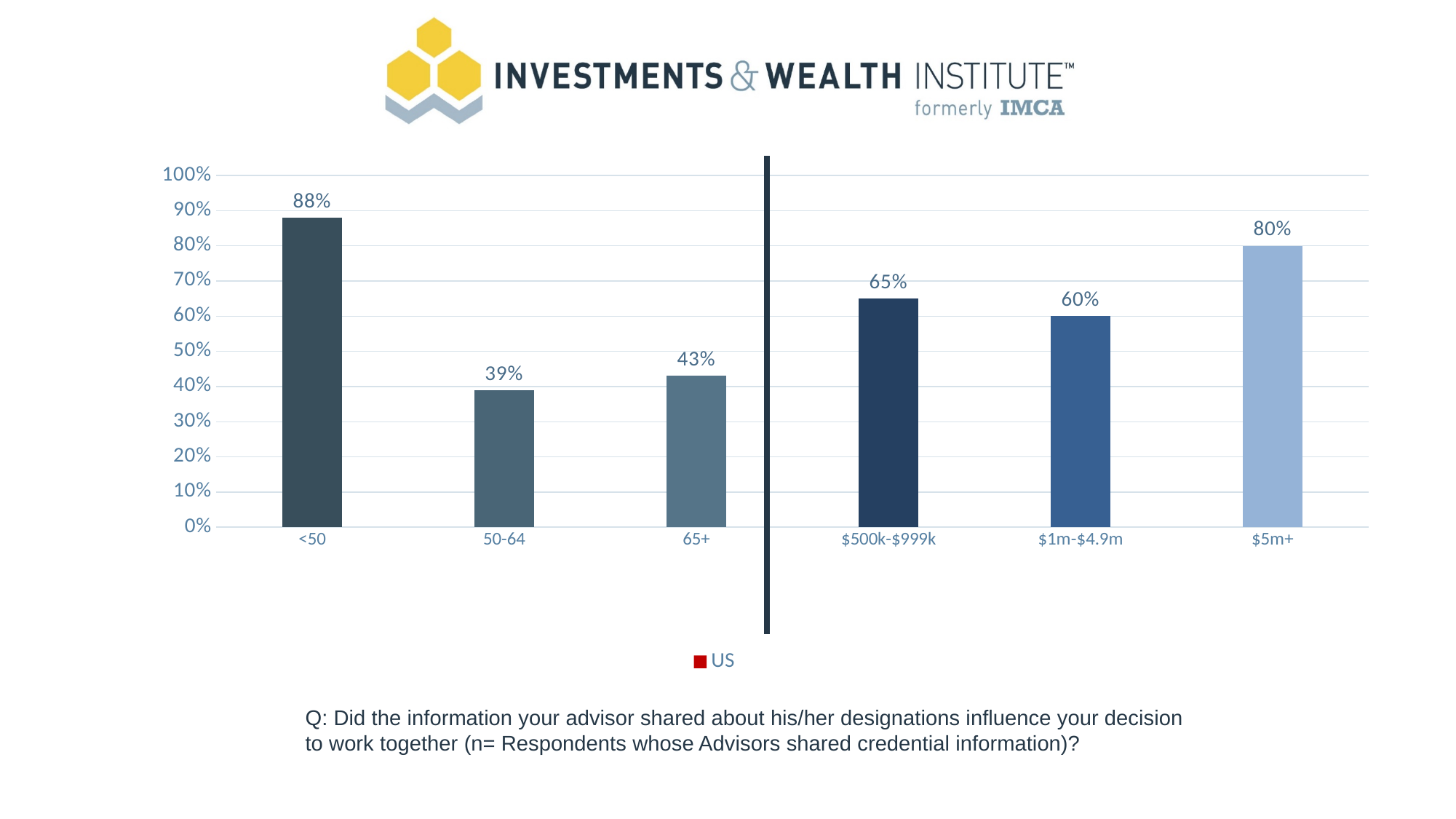
What series does the legend list? US What is the difference between the values for $500k-$999k and $1m-$4.9m? 5% What is the value for the $1m-$4.9m category? 60% What is the value for the $5m+ category? 80% Which category has the lowest value? 50-64 What is the value for the 50-64 category? 39% What is the difference between the values for <50 and 65+? 45% How many categories are shown on the x axis? 6 Which category has the highest value? <50 What is the value for the <50 category? 88% What kind of chart is shown on the slide? Bar chart Which is larger, the value for 65+ or the value for 50-64? 65+